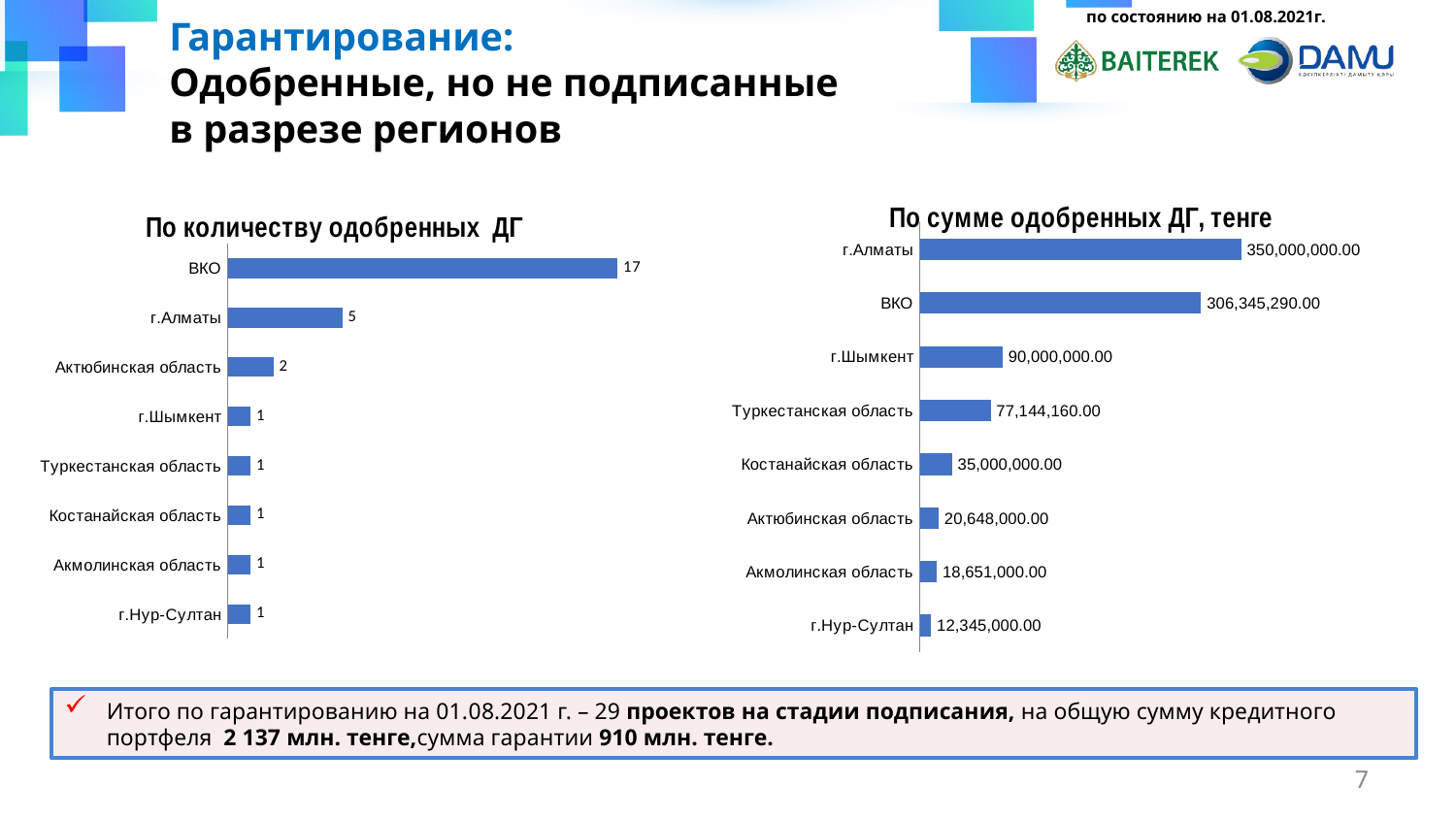
In the chart 'По сумме одобренных ДГ, тенге', which region has the lowest value? г.Нур-Султан In the chart 'По количеству одобренных ДГ', how many regions are shown? 8 In the chart 'По количеству одобренных ДГ', what is the value for ВКО? 17 In the chart 'По количеству одобренных ДГ', which region has the highest value? ВКО In the chart 'По сумме одобренных ДГ, тенге', what is the value for Туркестанская область? 77,144,160.00 In the chart 'По сумме одобренных ДГ, тенге', what is the value for г.Алматы? 350,000,000.00 In the chart 'По сумме одобренных ДГ, тенге', which is larger: the value for г.Шымкент or the value for Костанайская область? г.Шымкент In the chart 'По сумме одобренных ДГ, тенге', what is the value for Акмолинская область? 18,651,000.00 What type of chart is 'По сумме одобренных ДГ, тенге'? Bar chart In the chart 'По количеству одобренных ДГ', what is the difference between the values for ВКО and г.Алматы? 12 In the chart 'По сумме одобренных ДГ, тенге', what is the difference between the values for г.Алматы and ВКО? 43,654,710.00 In the chart 'По количеству одобренных ДГ', what is the value for г.Алматы? 5